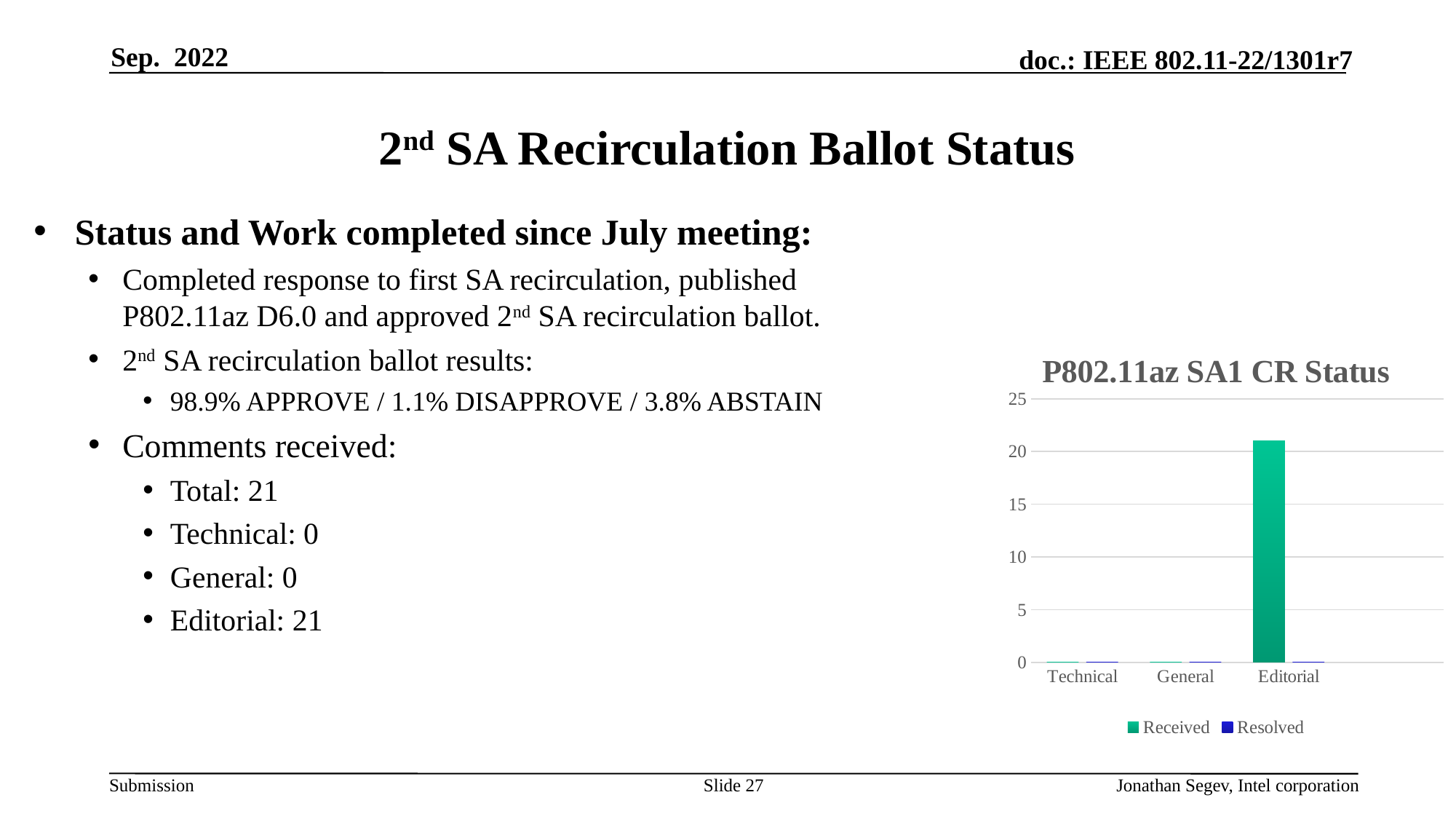
What is the Received value for General in the chart? 0 Is the Received value for Editorial greater or less than 10? greater Which category has the highest Received value in the chart? Editorial Is the Received value for Editorial greater or less than 25? less How many categories are shown on the x axis of the chart? 3 What is the title of the chart on the slide? P802.11az SA1 CR Status Which is larger in the chart, the Received value for Editorial or the Received value for Technical? Editorial How many series does the chart legend list? 2 Which series are listed in the chart legend? Received and Resolved Is the Received value for Editorial greater or less than 15? greater What is the Received value for Technical in the chart? 0 What kind of chart is shown on the slide? bar chart